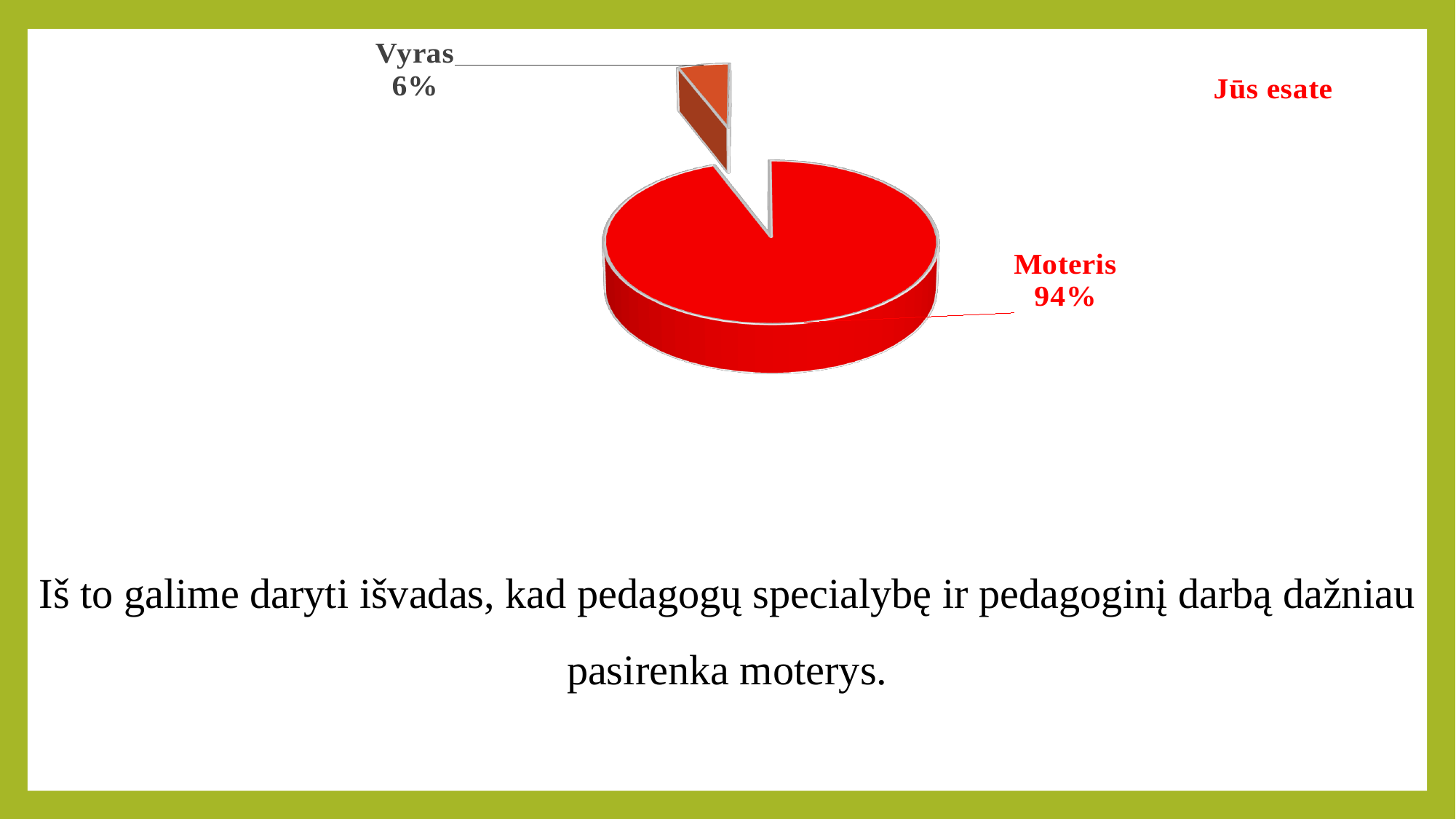
What share of the pie does Vyras take? 6% What is the difference between the Moteris and Vyras shares? 88% What is the value for Vyras? 6% Which category has the largest share of the pie? Moteris What colour is the Moteris slice? red What is the title of the chart? Jūs esate How many categories does the pie chart show? 2 Which category has the smallest share of the pie? Vyras Which is larger, the share for Vyras or the share for Moteris? Moteris What kind of chart is shown on the slide? pie chart What is the value for Moteris? 94%